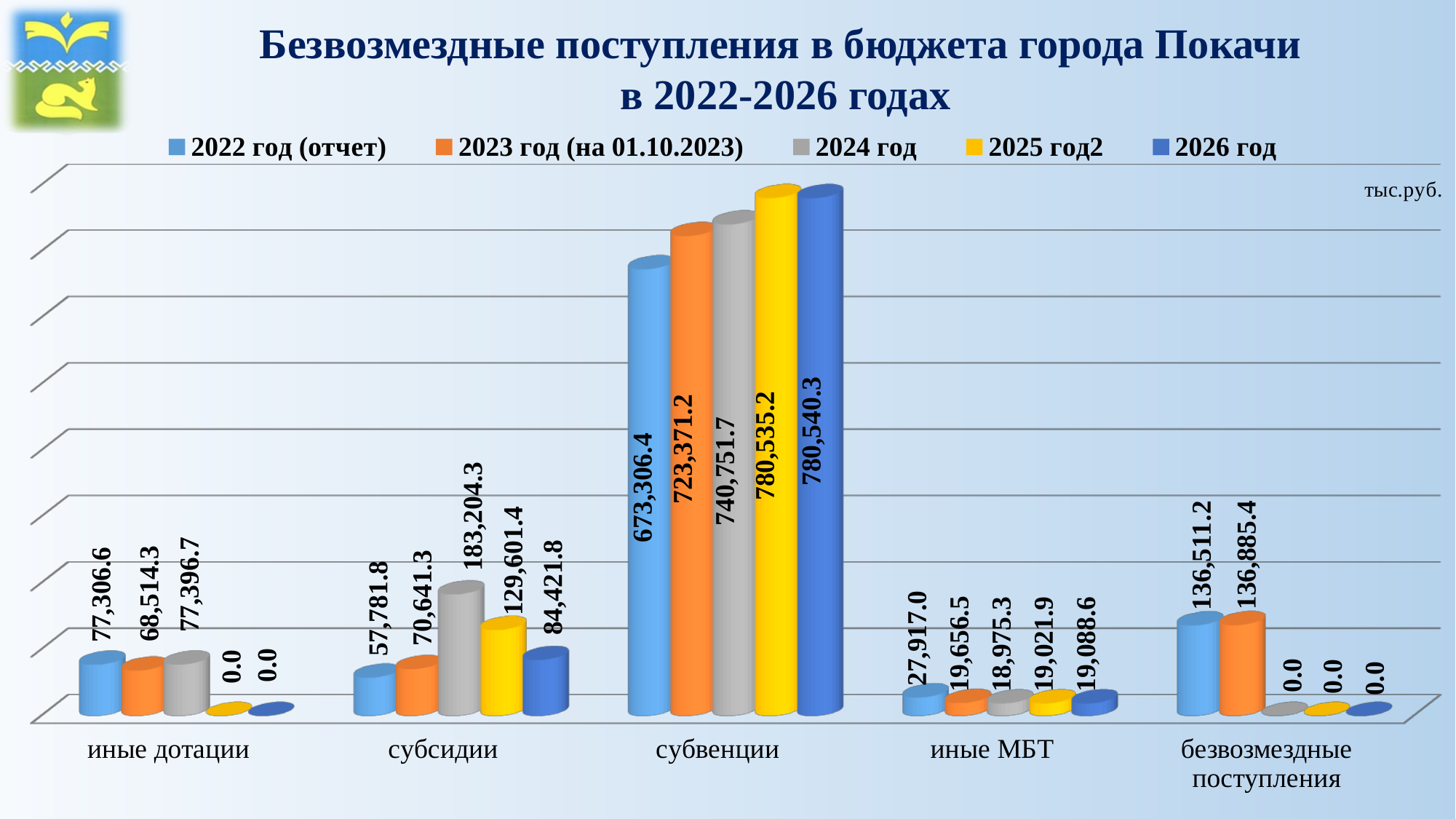
Which category has the highest value in the 2025 год2 series? субвенции What is the difference between the 2024 год and 2025 год2 values for субсидии? 53,602.9 What is the value for субвенции in the 2024 год series? 740,751.7 What is the value for субсидии in the 2022 год (отчет) series? 57,781.8 How many categories are shown on the x axis? 5 What is the value for иные МБТ in the 2026 год series? 19,088.6 Which is larger for иные дотации: the 2022 год (отчет) value or the 2023 год (на 01.10.2023) value? 2022 год (отчет) How many series does the legend list? 5 Do the values for субвенции rise or fall from the 2022 год (отчет) series to the 2026 год series? rise What kind of chart is shown on the slide? bar chart Which category has the lowest value in the 2022 год (отчет) series? иные МБТ What is the value for безвозмездные поступления in the 2023 год (на 01.10.2023) series? 136,885.4